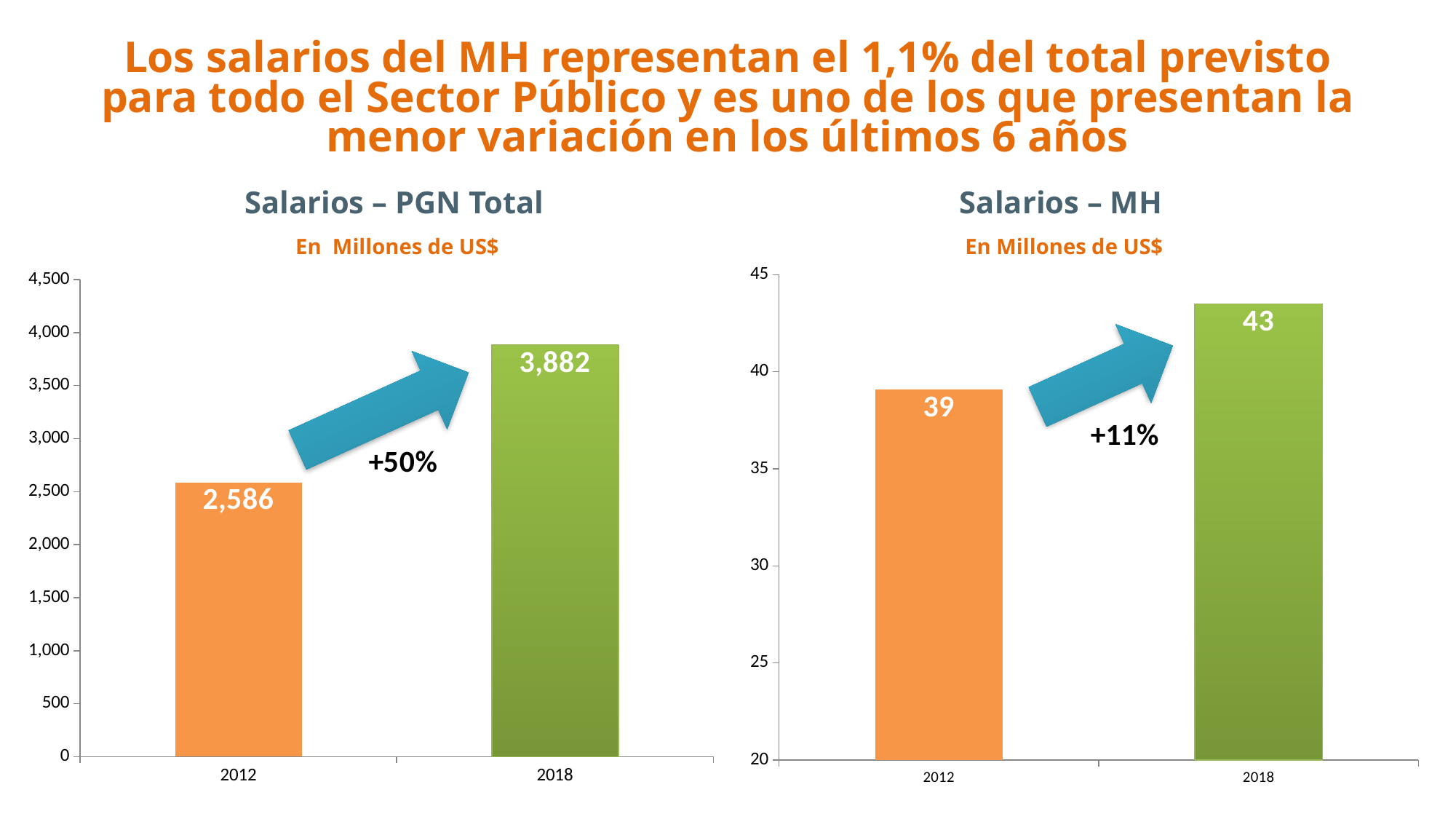
In the 'Salarios – PGN Total' chart, what is the difference between the 2018 and 2012 values? 1,296 What type of chart is the 'Salarios – PGN Total' chart? bar chart In the 'Salarios – PGN Total' chart, what is the value for 2012? 2,586 In the 'Salarios – MH' chart, which year has the lower value? 2012 In the 'Salarios – PGN Total' chart, what is the value for 2018? 3,882 In the 'Salarios – PGN Total' chart, which year has the higher value? 2018 In the 'Salarios – MH' chart, what is the value for 2012? 39 How many bars are shown in the 'Salarios – MH' chart? 2 What percentage change is annotated on the 'Salarios – MH' chart? +11% In the 'Salarios – PGN Total' chart, is the value for 2018 greater or less than 3,500? greater In the 'Salarios – MH' chart, what is the value for 2018? 43 In the 'Salarios – MH' chart, what is the difference between the 2018 and 2012 values? 4